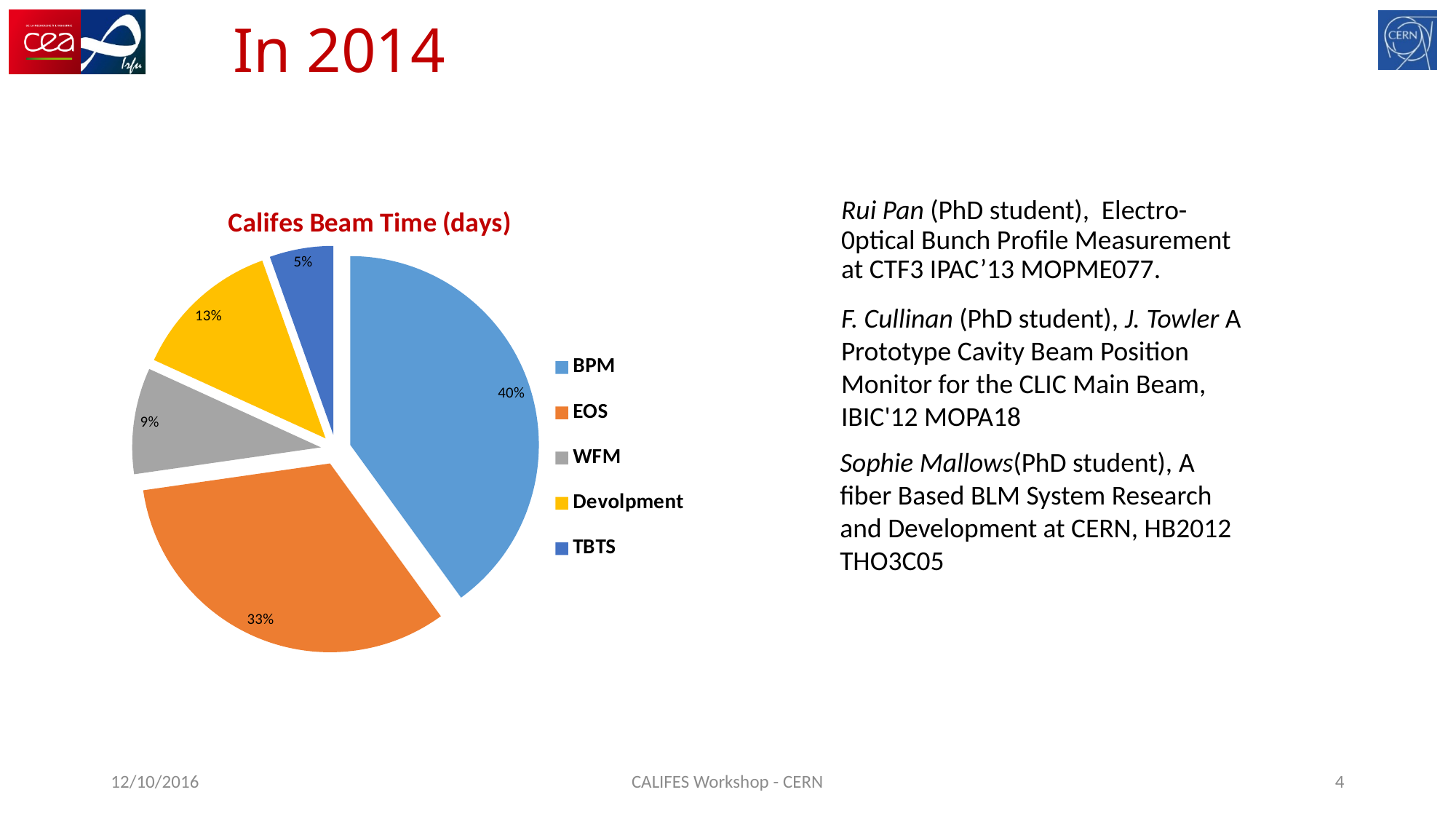
What share of the pie does WFM account for? 9% How many categories does the pie chart show? 5 Which category has the smallest slice of the pie? TBTS What share of the pie does TBTS account for? 5% What share of the pie does BPM account for? 40% Which category has the largest slice of the pie? BPM What is the title of the chart? Califes Beam Time (days) What type of chart is shown on the slide? pie chart What is the difference in percentage points between the BPM and EOS slices? 7% Which slice is larger, Devolpment or WFM? Devolpment